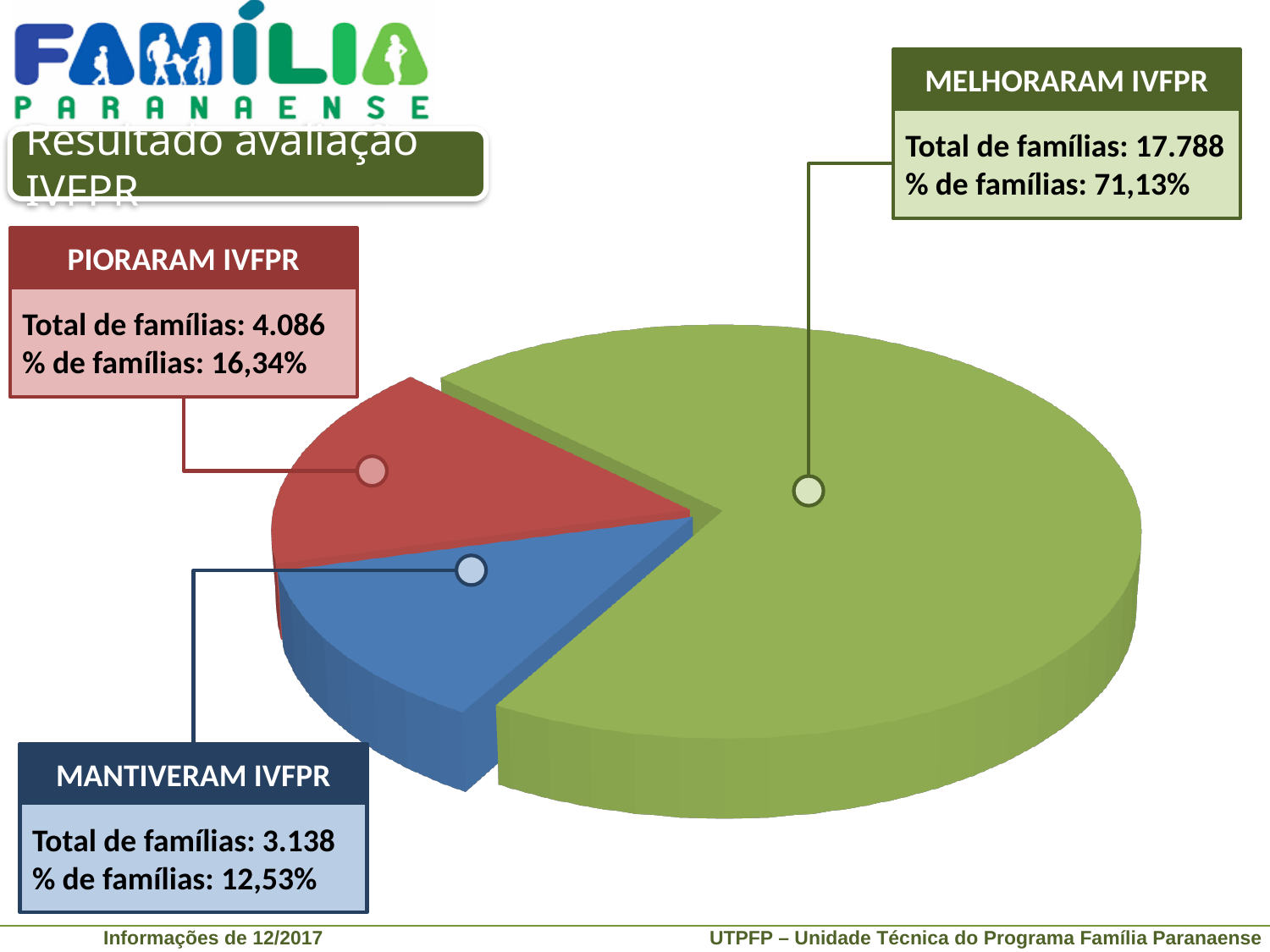
Which category has the smallest share of the pie? MANTIVERAM IVFPR What is the total number of families in the MELHORARAM IVFPR slice? 17.788 What percentage of families is shown for MANTIVERAM IVFPR? 12,53% How many slices does the pie chart have? 3 What kind of chart is shown on the slide? pie chart What colour is the MELHORARAM IVFPR slice? green Which category has the largest share of the pie? MELHORARAM IVFPR Which has more families, PIORARAM IVFPR or MANTIVERAM IVFPR? PIORARAM IVFPR What is the difference in the number of families between MELHORARAM IVFPR and PIORARAM IVFPR? 13.702 What is the difference in the number of families between PIORARAM IVFPR and MANTIVERAM IVFPR? 948 What percentage of families is shown for PIORARAM IVFPR? 16,34% What is the total number of families for MANTIVERAM IVFPR? 3.138